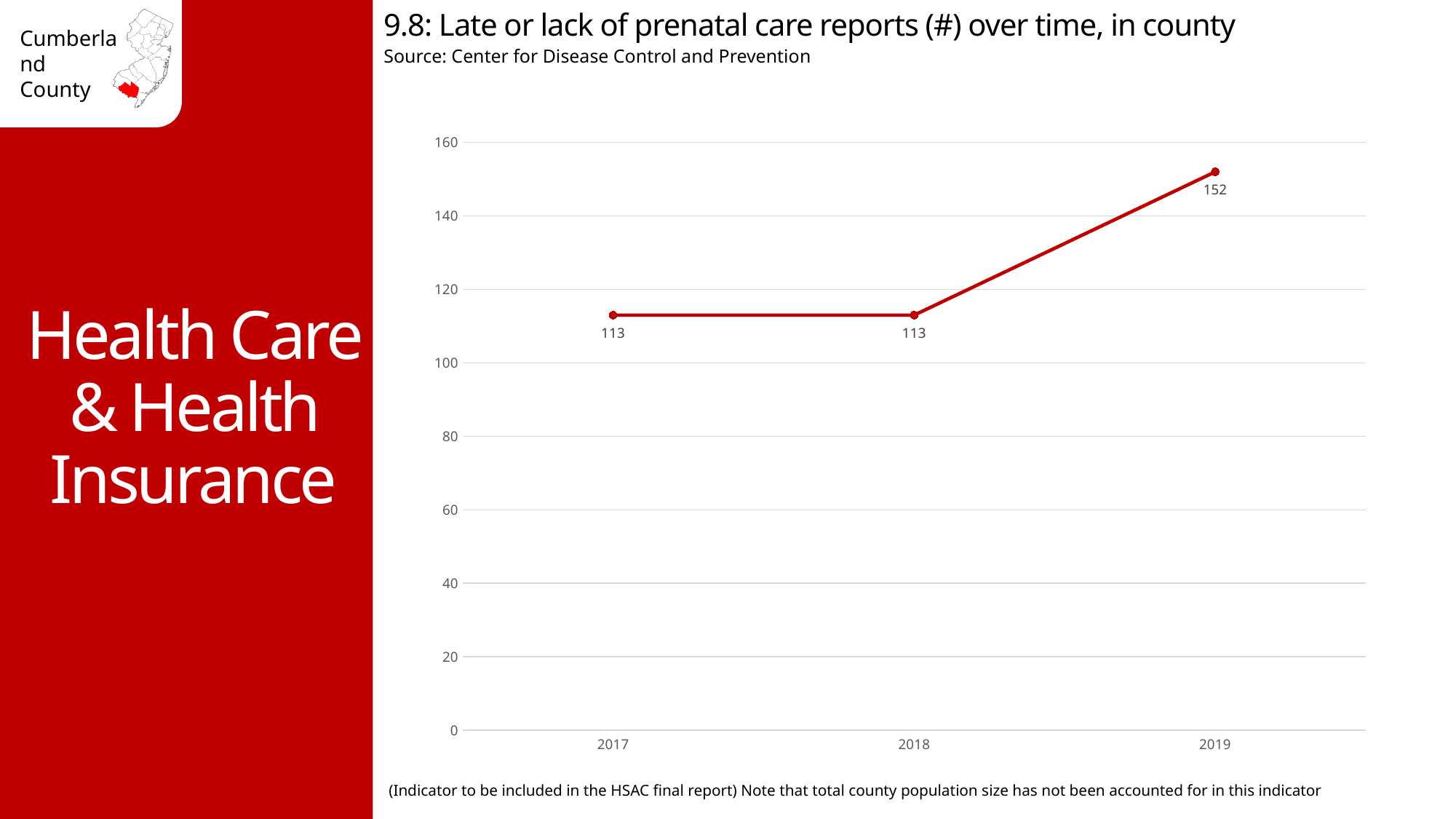
What is the source of the data shown in the chart? Center for Disease Control and Prevention What is the number of late or lack of prenatal care reports in 2019? 152 What kind of chart is shown on the slide? line chart Which year has the highest number of late or lack of prenatal care reports? 2019 Do the values rise or fall from 2018 to 2019? rise What is the number of late or lack of prenatal care reports in 2017? 113 What is the difference between the 2019 and 2018 values? 39 How many years are plotted on the chart? 3 What is the number of late or lack of prenatal care reports in 2018? 113 Which is larger, the value for 2017 or the value for 2019? 2019 Is the value for 2017 greater or less than 120? less Is the value for 2019 greater or less than 140? greater